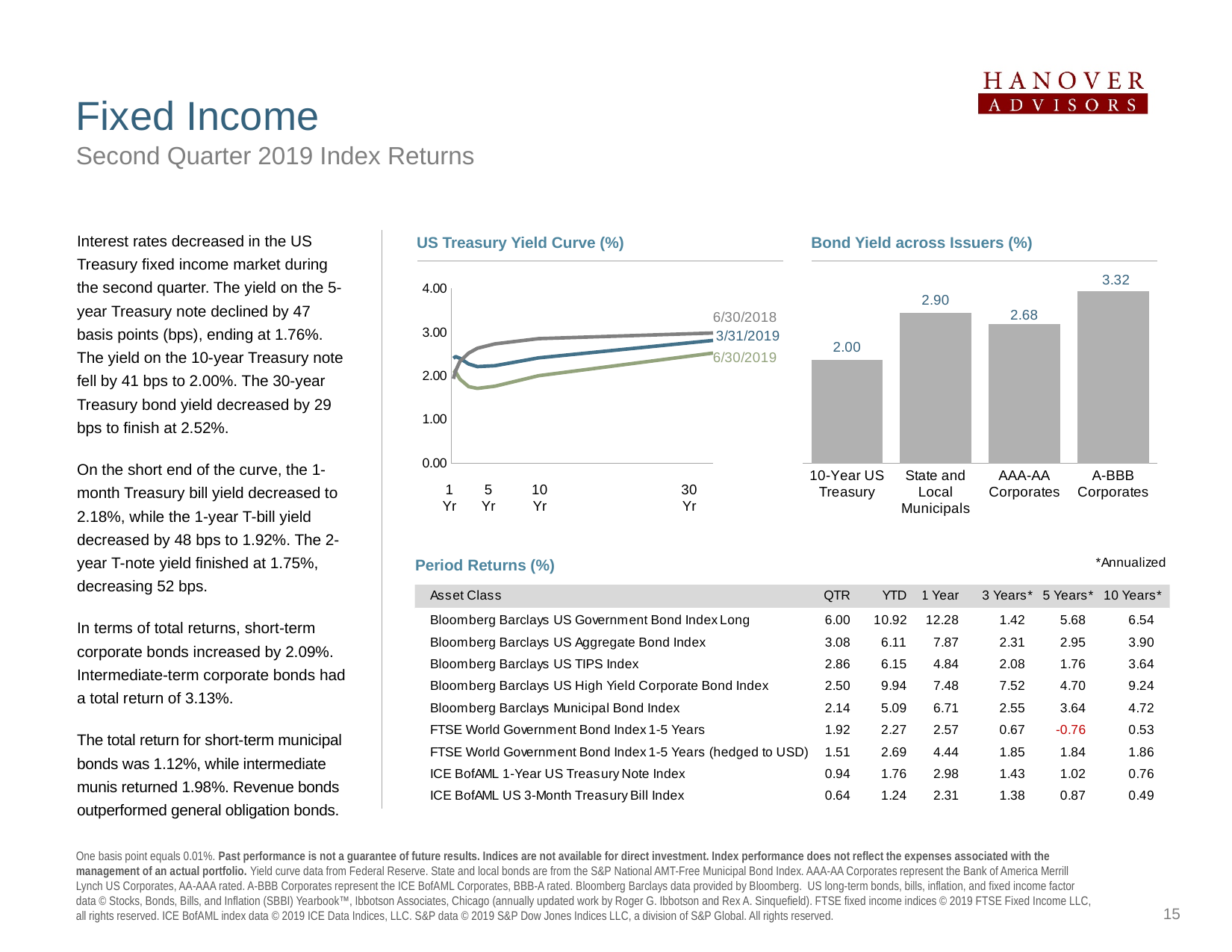
In the Bond Yield across Issuers chart, which category has the lowest value? 10-Year US Treasury How many series are shown in the US Treasury Yield Curve chart? 3 In the Bond Yield across Issuers chart, what is the value for State and Local Municipals? 2.90 What kind of chart is the US Treasury Yield Curve chart? Line chart In the Bond Yield across Issuers chart, which is larger: State and Local Municipals or AAA-AA Corporates? State and Local Municipals How many categories are shown in the Bond Yield across Issuers chart? 4 In the Bond Yield across Issuers chart, what is the difference between A-BBB Corporates and 10-Year US Treasury? 1.32 In the US Treasury Yield Curve chart, which series is the highest at 30 Yr? 6/30/2018 In the Bond Yield across Issuers chart, what is the value for A-BBB Corporates? 3.32 In the US Treasury Yield Curve chart, is the 6/30/2019 value at 30 Yr greater or less than 3.00? less What kind of chart is the Bond Yield across Issuers chart? Bar chart In the Bond Yield across Issuers chart, which category has the highest value? A-BBB Corporates